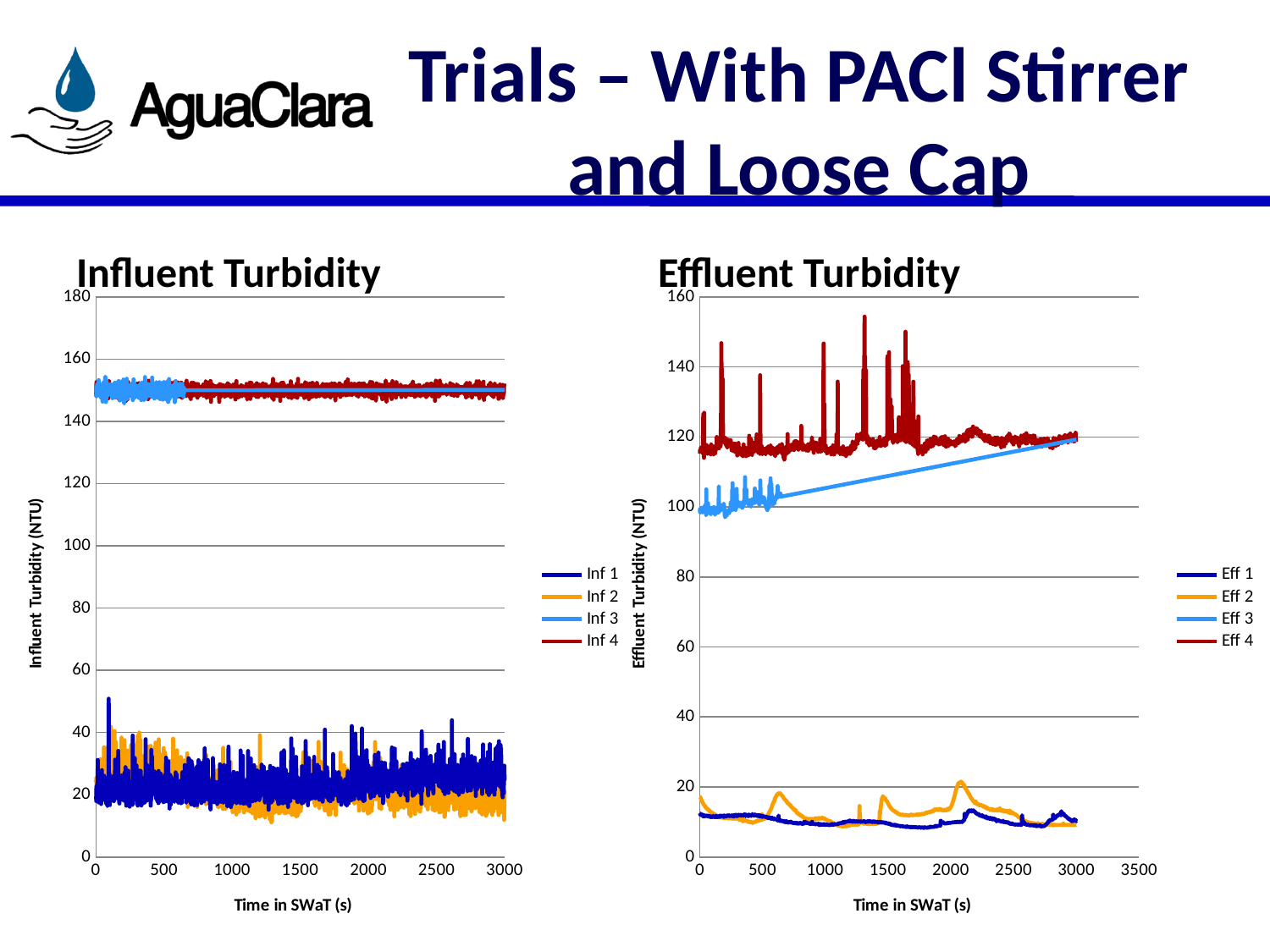
In the Influent Turbidity chart, are the values for Inf 4 greater or less than 140? greater How many series does the legend of the Effluent Turbidity chart list? 4 In the Influent Turbidity chart, which series has larger values, Inf 4 or Inf 1? Inf 4 What is the label of the y axis on the Effluent Turbidity chart? Effluent Turbidity (NTU) How many series does the legend of the Influent Turbidity chart list? 4 In the Effluent Turbidity chart, does the Eff 3 line rise or fall as time increases? rise What is the label of the x axis on the Influent Turbidity chart? Time in SWaT (s) In the Effluent Turbidity chart, are the values for Eff 2 greater or less than 40? less What kind of chart is the Influent Turbidity chart? line chart In the Influent Turbidity chart, are the values for Inf 1 greater or less than 60? less In the Effluent Turbidity chart, which series has larger values, Eff 4 or Eff 2? Eff 4